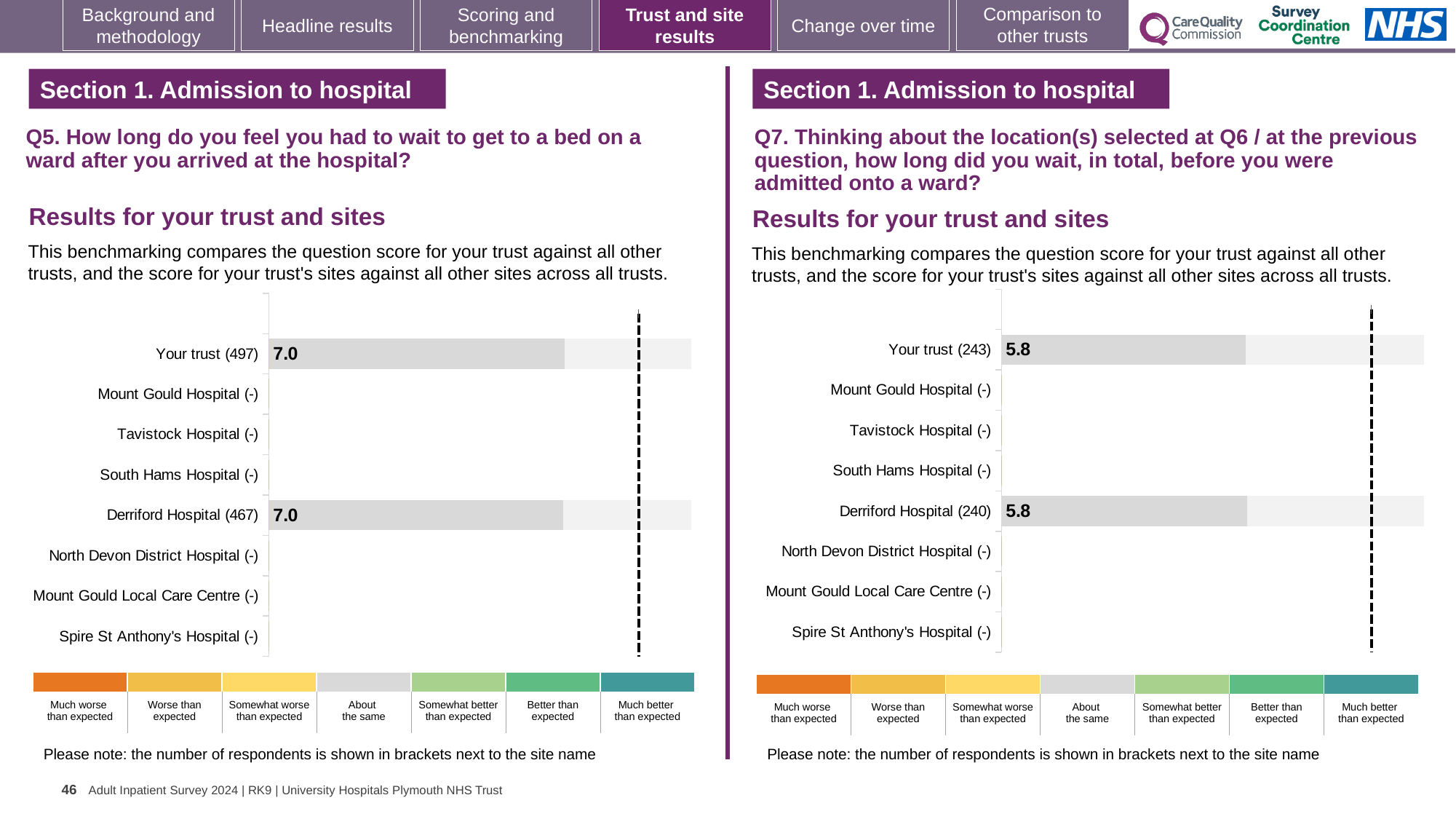
On the left chart (Q5), what is the score for Derriford Hospital (467)? 7.0 How many site/trust categories are listed on the right chart (Q7)? 8 On the left chart (Q5), how many respondents are shown in brackets for Derriford Hospital? 467 What kind of chart is used on the left (Q5)? Bar chart On the right chart (Q7), what is the score for Derriford Hospital (240)? 5.8 Is the score for Your trust on the left chart (Q5) larger or smaller than the score for Your trust on the right chart (Q7)? Larger On the right chart (Q7), what is the score for Your trust (243)? 5.8 On the left chart (Q5), what is the score for Your trust (497)? 7.0 On the left chart (Q5), what is the difference between the score for Your trust and the score for Derriford Hospital? 0.0 On the right chart (Q7), what is the difference between the score for Your trust and the score for Derriford Hospital? 0.0 How many site/trust categories are listed on the left chart (Q5)? 8 On the right chart (Q7), how many respondents are shown in brackets for Your trust? 243